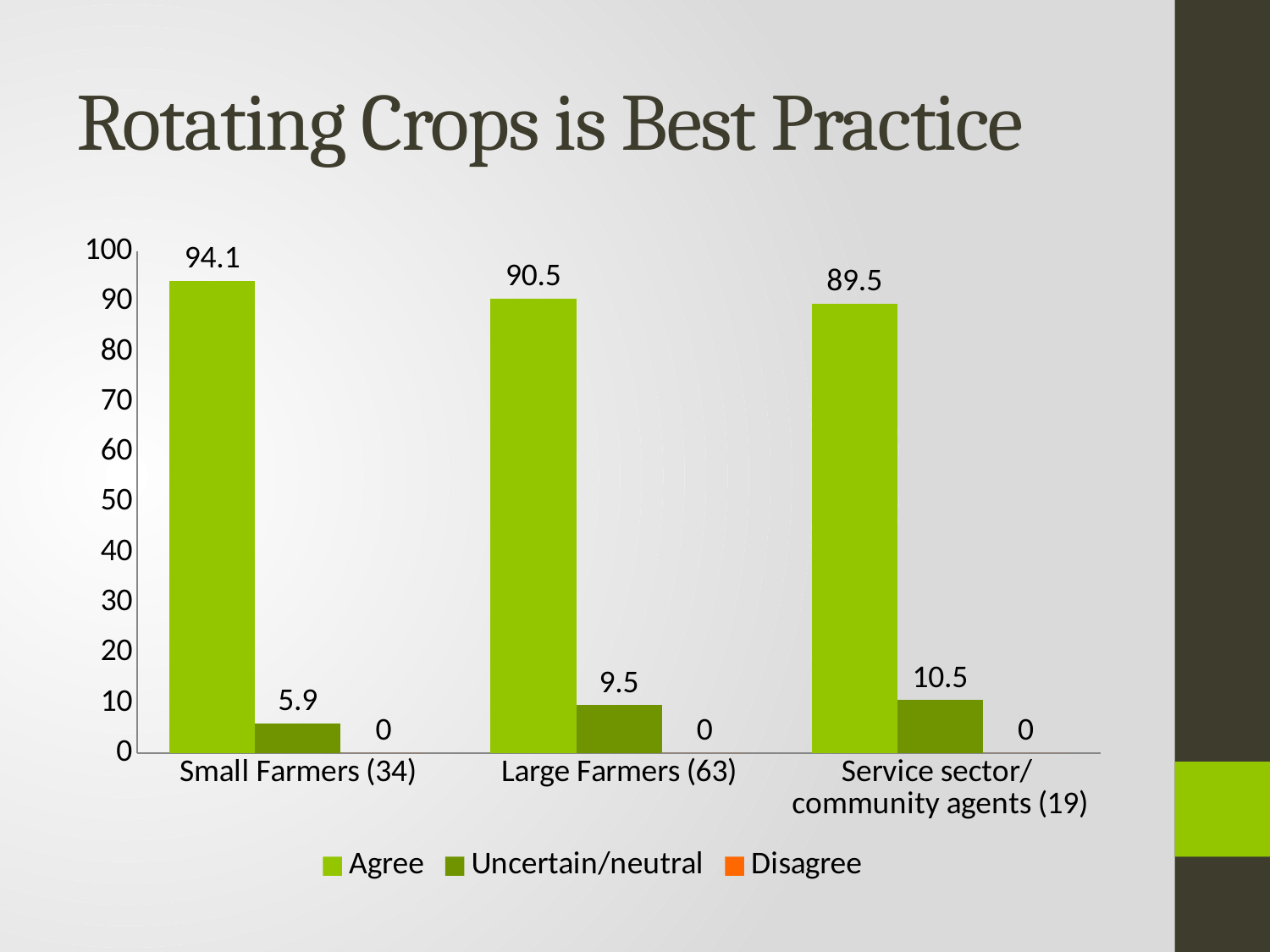
What is the title of the slide? Rotating Crops is Best Practice How many series does the legend list? 3 Which category has the highest Agree value? Small Farmers (34) Which category has the lowest Uncertain/neutral value? Small Farmers (34) What kind of chart is shown on the slide? Bar chart Which is larger: the Uncertain/neutral value for Large Farmers (63) or for Service sector/community agents (19)? Service sector/community agents (19) What is the Uncertain/neutral value for Large Farmers (63)? 9.5 What is the Agree value for Service sector/community agents (19)? 89.5 What is the difference between the Agree values for Small Farmers (34) and Large Farmers (63)? 3.6 How many categories are shown on the x axis? 3 What is the Disagree value for Small Farmers (34)? 0 What is the Agree value for Small Farmers (34)? 94.1